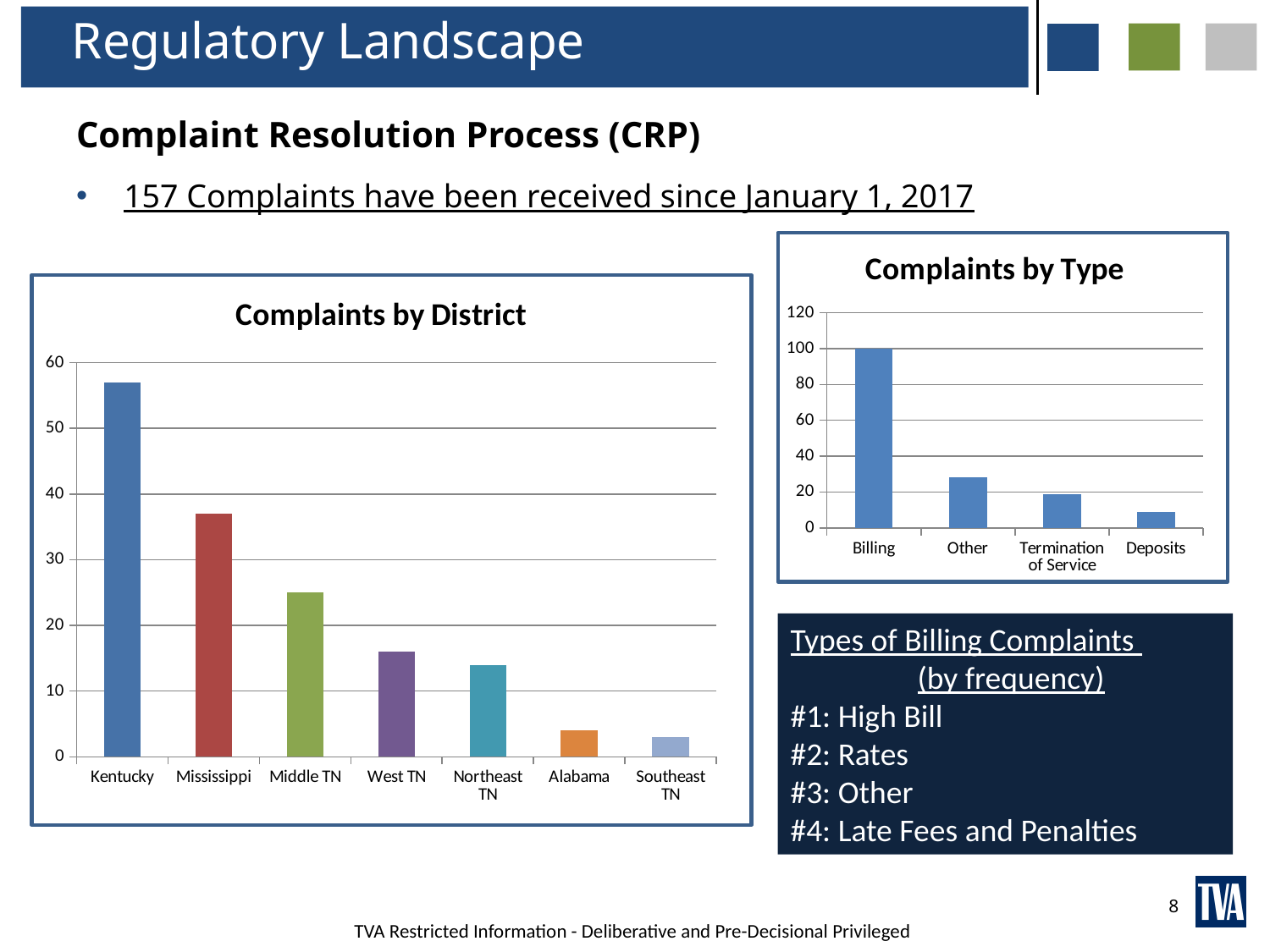
In the "Complaints by Type" chart, which type has the fewest complaints? Deposits In the "Complaints by Type" chart, is the value for Other greater or less than 20? greater In the "Complaints by District" chart, which has more complaints, Middle TN or West TN? Middle TN In the "Complaints by District" chart, do the values rise or fall from left to right along the x axis? fall In the "Complaints by Type" chart, which type has the most complaints? Billing In the "Complaints by District" chart, is the value for Kentucky greater or less than 50? greater How many districts are shown in the "Complaints by District" chart? 7 How many complaint types are shown in the "Complaints by Type" chart? 4 In the "Complaints by District" chart, which district has the highest number of complaints? Kentucky What kind of chart is the "Complaints by District" chart? bar chart In the "Complaints by District" chart, is the value for Mississippi greater or less than 40? less